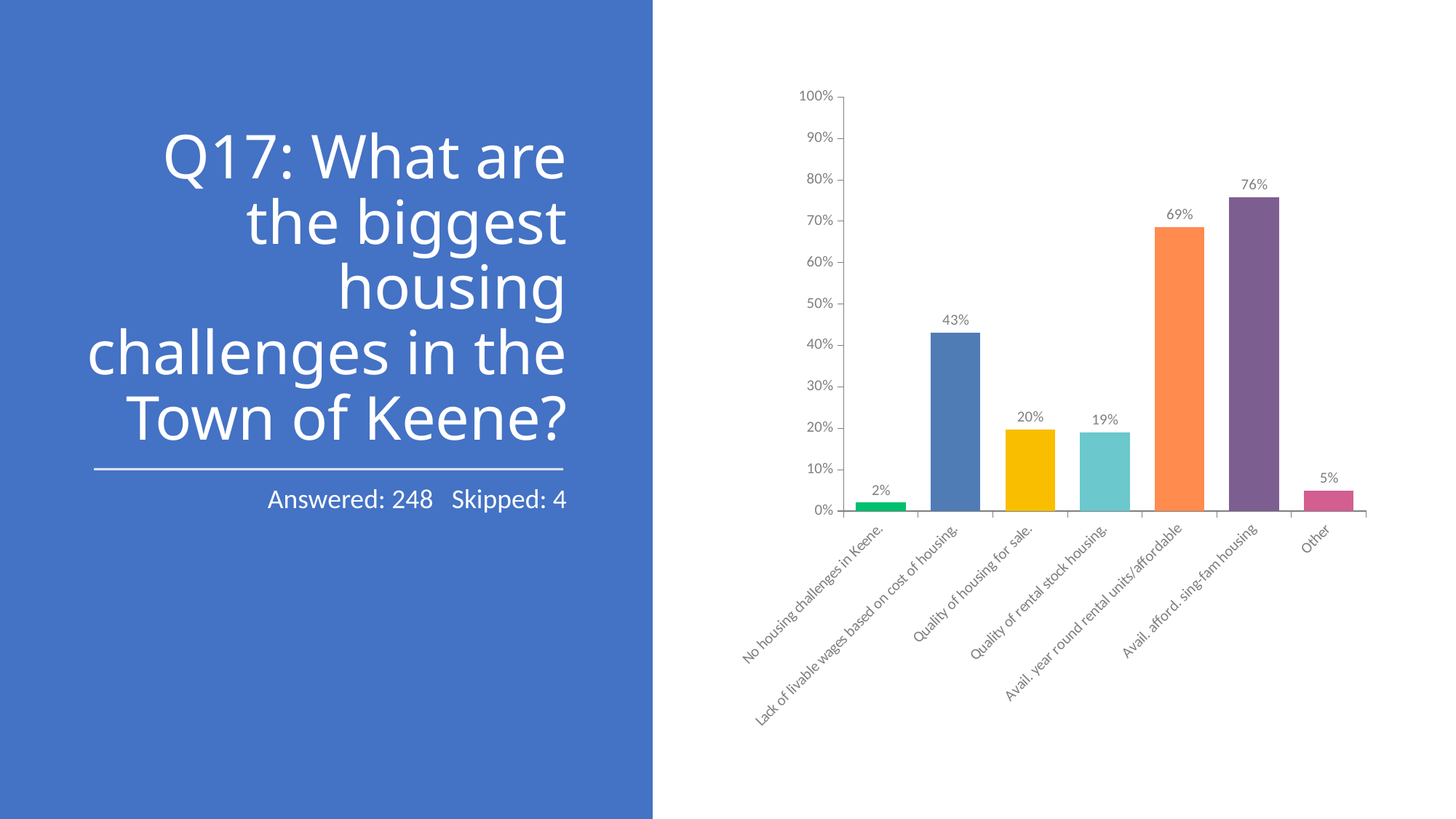
How many categories are shown on the chart? 7 Which category has the highest value? Avail. afford. sing-fam housing How many respondents answered the question according to the slide? 248 What is the difference between "Avail. afford. sing-fam housing" and "Avail. year round rental units/affordable"? 7% What percentage is shown for "Other"? 5% Which category has the lowest value? No housing challenges in Keene. What is the difference between "Quality of housing for sale." and "Quality of rental stock housing."? 1% What kind of chart is shown on the slide? Bar chart What percentage of respondents selected "Avail. afford. sing-fam housing"? 76% Which is larger: "Lack of livable wages based on cost of housing." or "Quality of housing for sale."? Lack of livable wages based on cost of housing. What is the value for "Lack of livable wages based on cost of housing."? 43% Is the value for "Avail. year round rental units/affordable" greater or less than 60%? greater